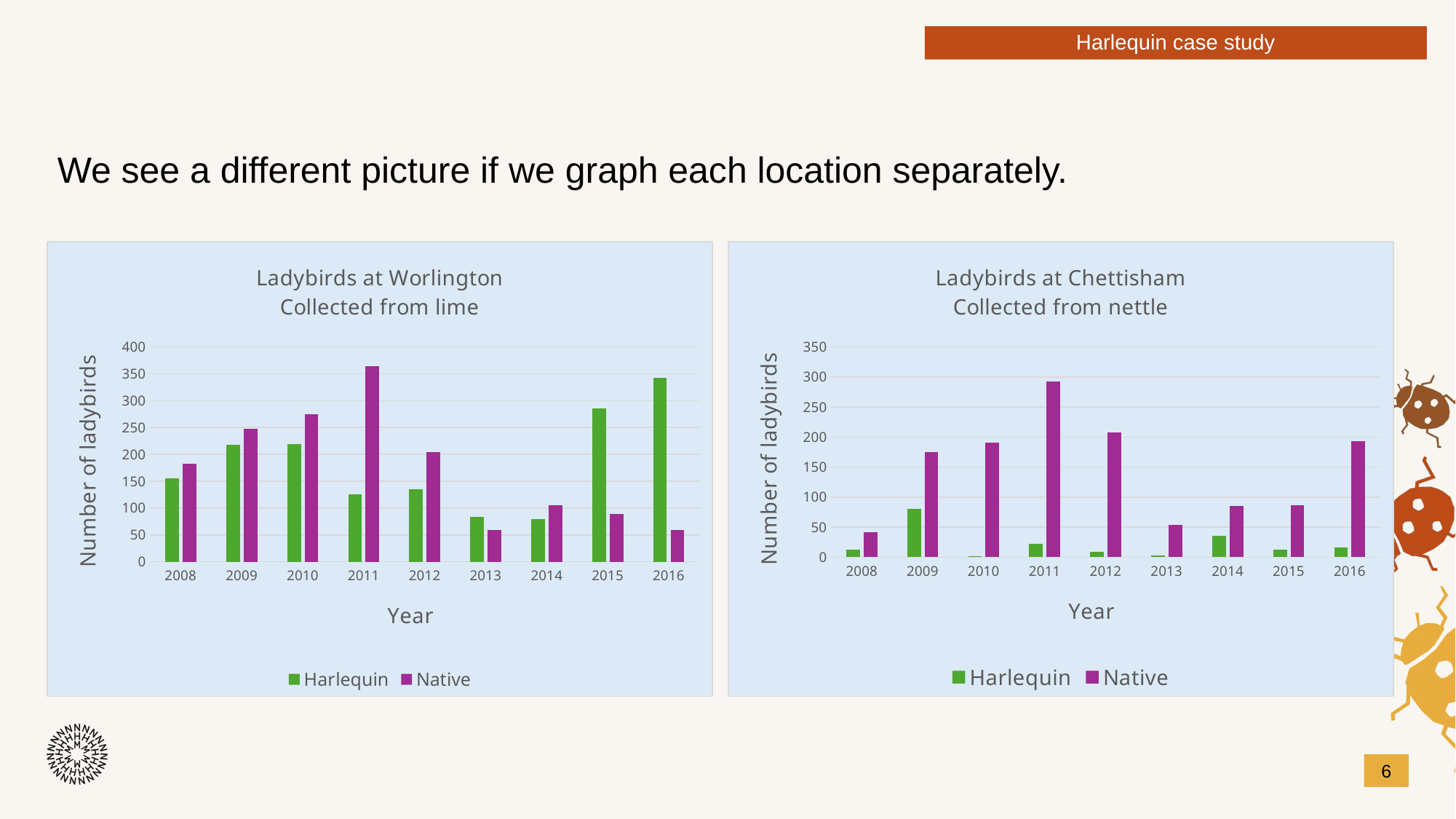
In the 'Ladybirds at Worlington' chart, which series has the larger value in 2016, Harlequin or Native? Harlequin In the 'Ladybirds at Chettisham' chart, which year has the highest Native value? 2011 In the 'Ladybirds at Chettisham' chart, is the Native value for 2011 greater or less than 250? greater In the 'Ladybirds at Worlington' chart, is the Native value for 2011 greater or less than 350? greater How many series does the legend of the 'Ladybirds at Worlington' chart list? 2 In the 'Ladybirds at Worlington' chart, which year has the highest Native value? 2011 In the 'Ladybirds at Chettisham' chart, how many years are shown on the x axis? 9 In the 'Ladybirds at Worlington' chart, is the Harlequin value for 2015 greater or less than 250? greater In the 'Ladybirds at Chettisham' chart, which year has the highest Harlequin value? 2009 What kind of chart is the 'Ladybirds at Chettisham' chart? Bar chart